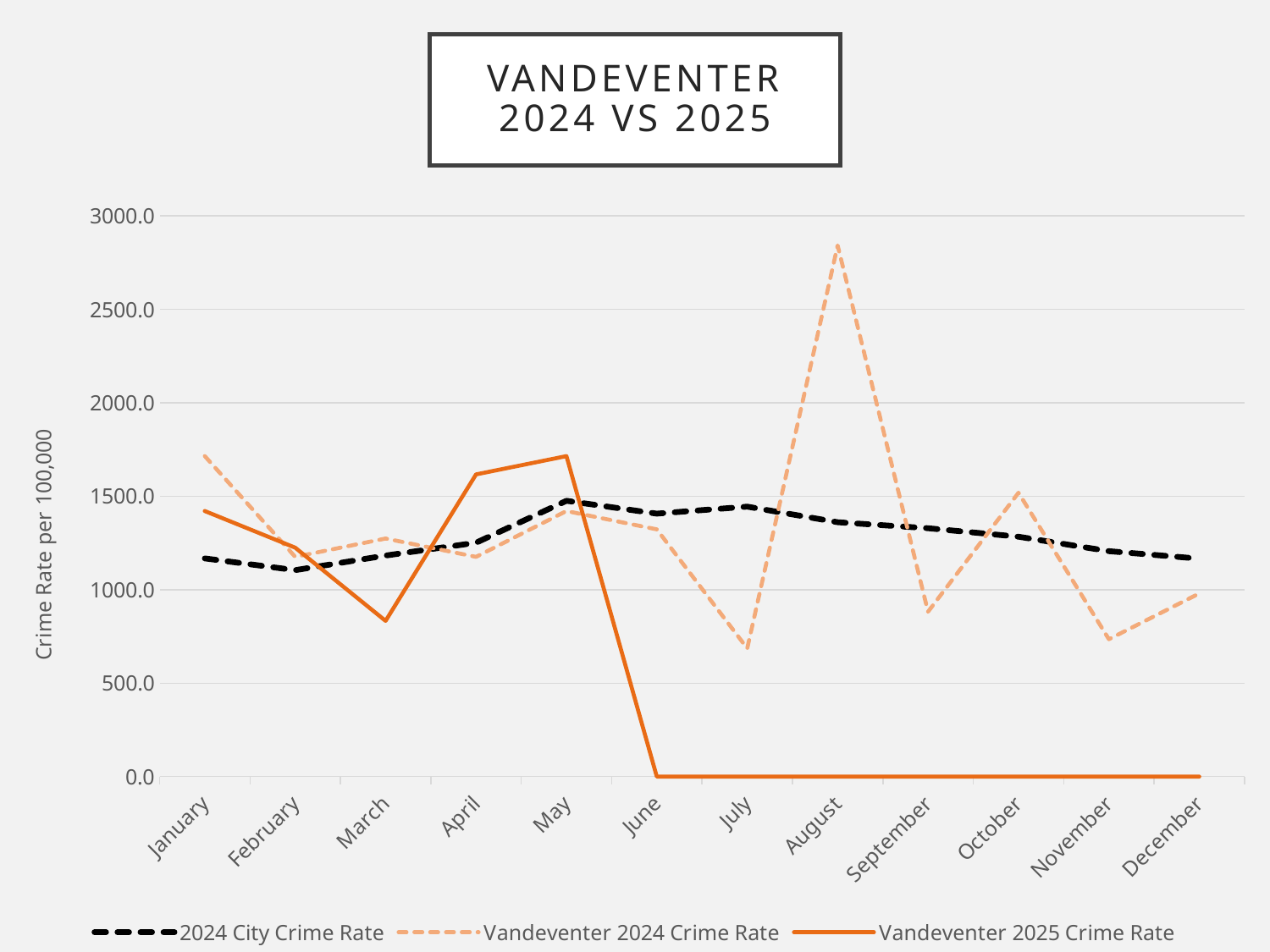
What is the Vandeventer 2025 Crime Rate in December? 0.0 What is the Vandeventer 2025 Crime Rate in June? 0.0 Does the 2024 City Crime Rate rise or fall from May to December? fall Is the Vandeventer 2024 Crime Rate in August greater or less than 2500? greater What is the title of the chart? VANDEVENTER 2024 VS 2025 How many series does the legend list? 3 Is the Vandeventer 2025 Crime Rate in March greater or less than 1000? less In which month is the Vandeventer 2024 Crime Rate highest? August In which month is the Vandeventer 2025 Crime Rate highest? May What kind of chart is shown on the slide? line chart How many months are plotted along the x axis? 12 In April, which is higher: the Vandeventer 2025 Crime Rate or the 2024 City Crime Rate? Vandeventer 2025 Crime Rate